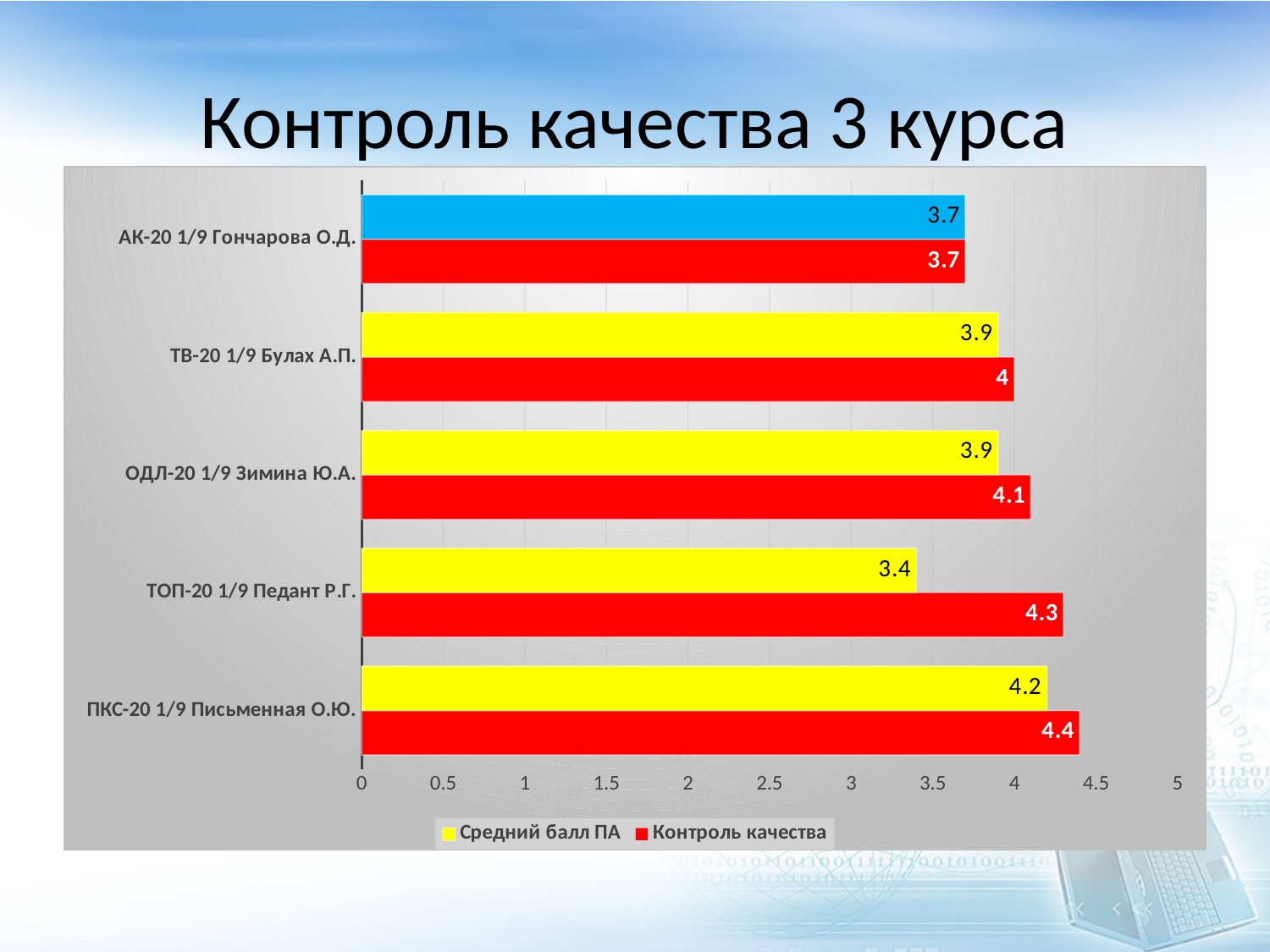
What is the difference between the Контроль качества and Средний балл ПА values for ТОП-20 1/9 Педант Р.Г.? 0.9 What is the Контроль качества value for ТВ-20 1/9 Булах А.П.? 4 How many series does the legend list? 2 What type of chart is shown on the slide? Bar chart How many categories (groups) are shown on the chart? 5 What is the Средний балл ПА value for ТОП-20 1/9 Педант Р.Г.? 3.4 Is the Средний балл ПА value for ПКС-20 1/9 Письменная О.Ю. greater or less than 4? greater What is the title of the chart? Контроль качества 3 курса Which is larger for ОДЛ-20 1/9 Зимина Ю.А.: Средний балл ПА or Контроль качества? Контроль качества Which category has the highest Контроль качества value? ПКС-20 1/9 Письменная О.Ю. What is the Контроль качества value for ПКС-20 1/9 Письменная О.Ю.? 4.4 Which category has the lowest Средний балл ПА value? ТОП-20 1/9 Педант Р.Г.